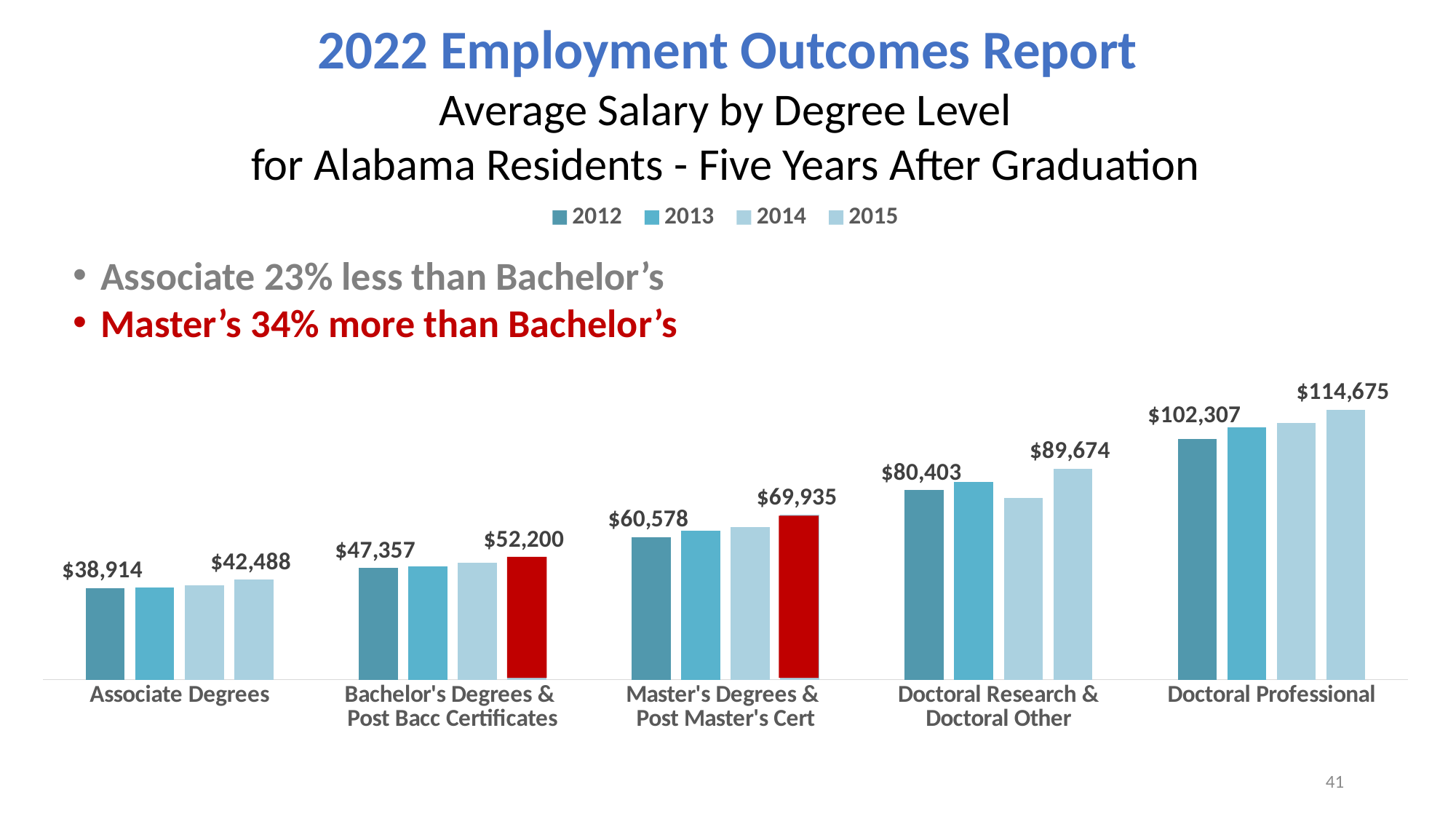
Which degree level has the lowest 2012 average salary? Associate Degrees What kind of chart is shown on the slide? Bar chart What is the difference between the 2015 and 2012 average salaries for Bachelor's Degrees & Post Bacc Certificates? $4,843 What is the 2012 average salary for Master's Degrees & Post Master's Cert? $60,578 How many degree level categories are shown on the x axis? 5 What is the 2015 average salary for Doctoral Professional? $114,675 What is the 2012 average salary for Doctoral Research & Doctoral Other? $80,403 What is the difference between the 2015 average salaries for Master's Degrees & Post Master's Cert and Associate Degrees? $27,447 Which is larger: the 2015 average salary for Doctoral Research & Doctoral Other or the 2012 average salary for Doctoral Professional? 2012 Doctoral Professional How many series does the legend list? 4 Which degree level has the highest 2015 average salary? Doctoral Professional What is the 2015 average salary for Associate Degrees? $42,488